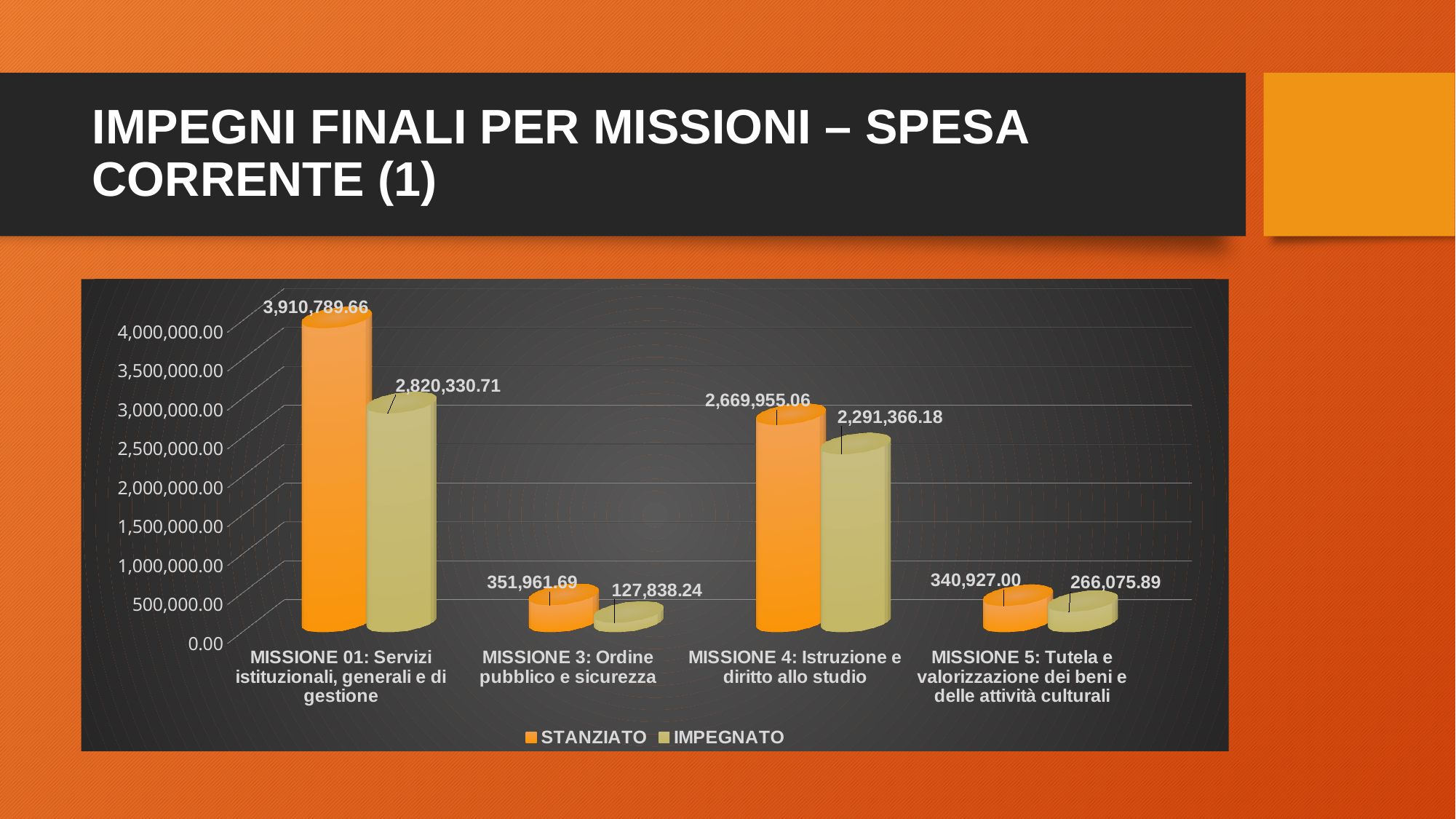
How many missions (categories) are shown on the chart? 4 What is the STANZIATO value for MISSIONE 5: Tutela e valorizzazione dei beni e delle attività culturali? 340,927.00 Which mission has the lowest IMPEGNATO value? MISSIONE 3: Ordine pubblico e sicurezza What is the STANZIATO value for MISSIONE 01: Servizi istituzionali, generali e di gestione? 3,910,789.66 What is the IMPEGNATO value for MISSIONE 3: Ordine pubblico e sicurezza? 127,838.24 Which is larger: the STANZIATO value for MISSIONE 3 or the STANZIATO value for MISSIONE 5? MISSIONE 3 Which mission has the highest STANZIATO value? MISSIONE 01: Servizi istituzionali, generali e di gestione How many series does the legend list? 2 What is the difference between the STANZIATO and IMPEGNATO values for MISSIONE 4: Istruzione e diritto allo studio? 378,588.88 What is the IMPEGNATO value for MISSIONE 4: Istruzione e diritto allo studio? 2,291,366.18 What is the difference between the STANZIATO and IMPEGNATO values for MISSIONE 01? 1,090,458.95 What kind of chart is shown on the slide? Bar chart